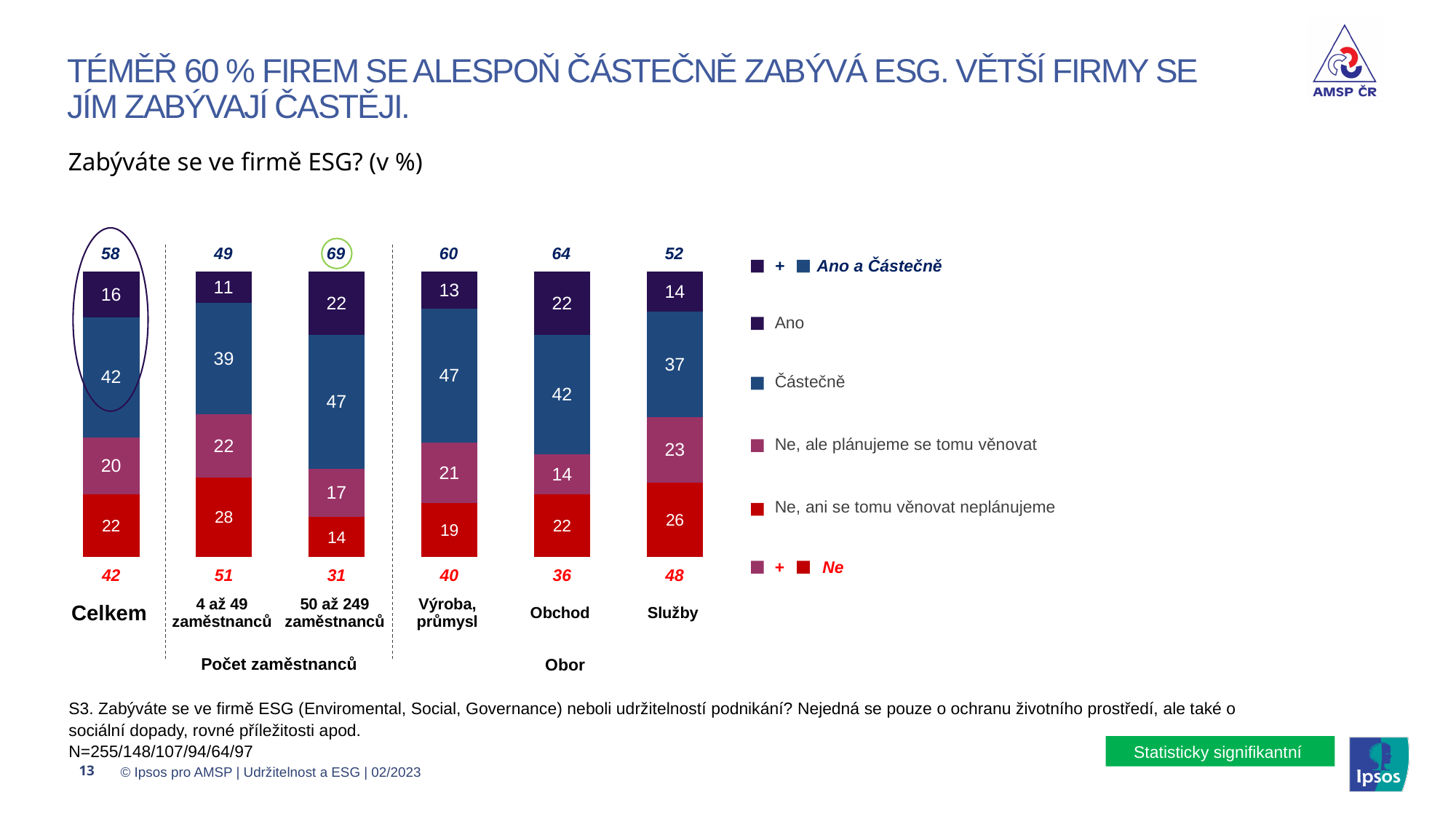
Which category has the lowest combined 'Ano a Částečně' value? 4 až 49 zaměstnanců How many categories (bars) are plotted in the chart? 6 What is the title of the chart? Zabýváte se ve firmě ESG? (v %) What is the combined 'Ano a Částečně' value shown above the 'Obchod' bar? 64 What is the 'Ne, ani se tomu věnovat neplánujeme' value for '4 až 49 zaměstnanců'? 28 Which is larger: the 'Ne' total for 'Služby' or for 'Obchod'? Služby What is the 'Ano' value for the 'Celkem' bar? 16 What is the 'Částečně' value for '50 až 249 zaměstnanců'? 47 What type of chart is shown on the slide? stacked bar chart What is the difference between the 'Ano' values for '50 až 249 zaměstnanců' and '4 až 49 zaměstnanců'? 11 Which category has the highest combined 'Ano a Částečně' value? 50 až 249 zaměstnanců What is the total of the 'Ne, ale plánujeme se tomu věnovat' and 'Ne, ani se tomu věnovat neplánujeme' segments for 'Výroba, průmysl'? 40